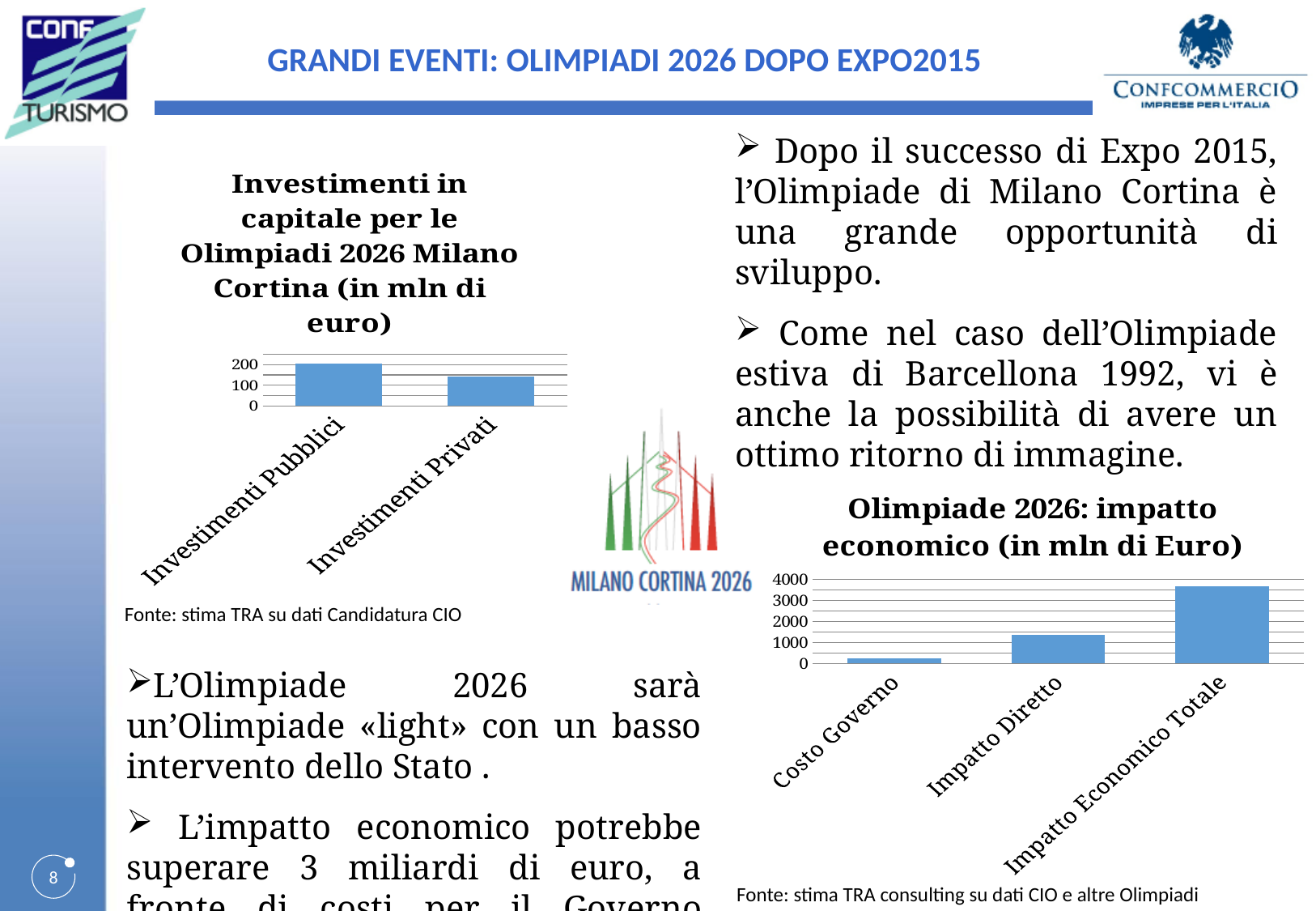
In the 'Olimpiade 2026: impatto economico' chart, is the value for Costo Governo greater or less than 1000? less In the 'Investimenti in capitale per le Olimpiadi 2026 Milano Cortina' chart, is the value for Investimenti Privati greater or less than 100? greater In the 'Investimenti in capitale per le Olimpiadi 2026 Milano Cortina' chart, which category has the higher value? Investimenti Pubblici What kind of chart is the 'Olimpiade 2026: impatto economico' chart? Bar chart How many categories are shown in the 'Investimenti in capitale per le Olimpiadi 2026 Milano Cortina' chart? 2 In the 'Olimpiade 2026: impatto economico' chart, is the value for Impatto Economico Totale greater or less than 3000? greater How many categories are shown in the 'Olimpiade 2026: impatto economico' chart? 3 What kind of chart is the 'Investimenti in capitale per le Olimpiadi 2026 Milano Cortina' chart? Bar chart In the 'Olimpiade 2026: impatto economico' chart, do the values rise or fall from left to right? Rise In the 'Olimpiade 2026: impatto economico' chart, which category has the highest value? Impatto Economico Totale In the 'Olimpiade 2026: impatto economico' chart, which category has the lowest value? Costo Governo